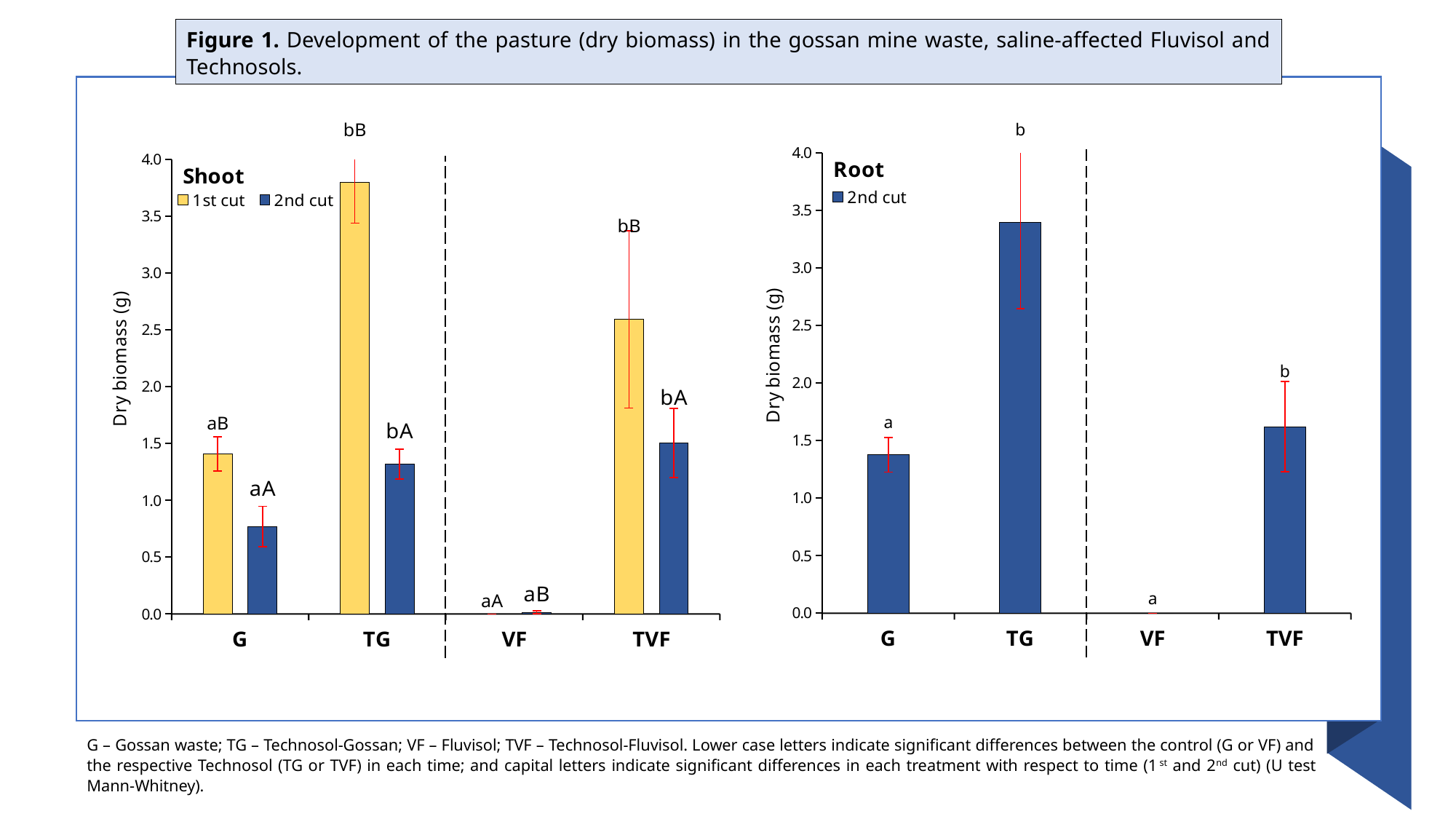
How many categories are shown on the x axis of the Root chart? 4 What is the y-axis label of the Root chart? Dry biomass (g) How many series does the legend of the Root chart list? 1 How many series does the legend of the Shoot chart list? 2 In the Shoot chart, is the 1st cut value for TG greater or less than 3.5? greater In the Root chart, which category has the highest value? TG In the Shoot chart, which category has the lowest 1st cut value? VF What kind of chart is the Shoot chart? bar chart In the Shoot chart, which category has the highest 1st cut value? TG In the Root chart, is the value for TG greater or less than 3.0? greater In the Shoot chart, which is larger for TVF, the 1st cut or the 2nd cut? 1st cut In the Shoot chart, is the 2nd cut value for G greater or less than 1.0? less